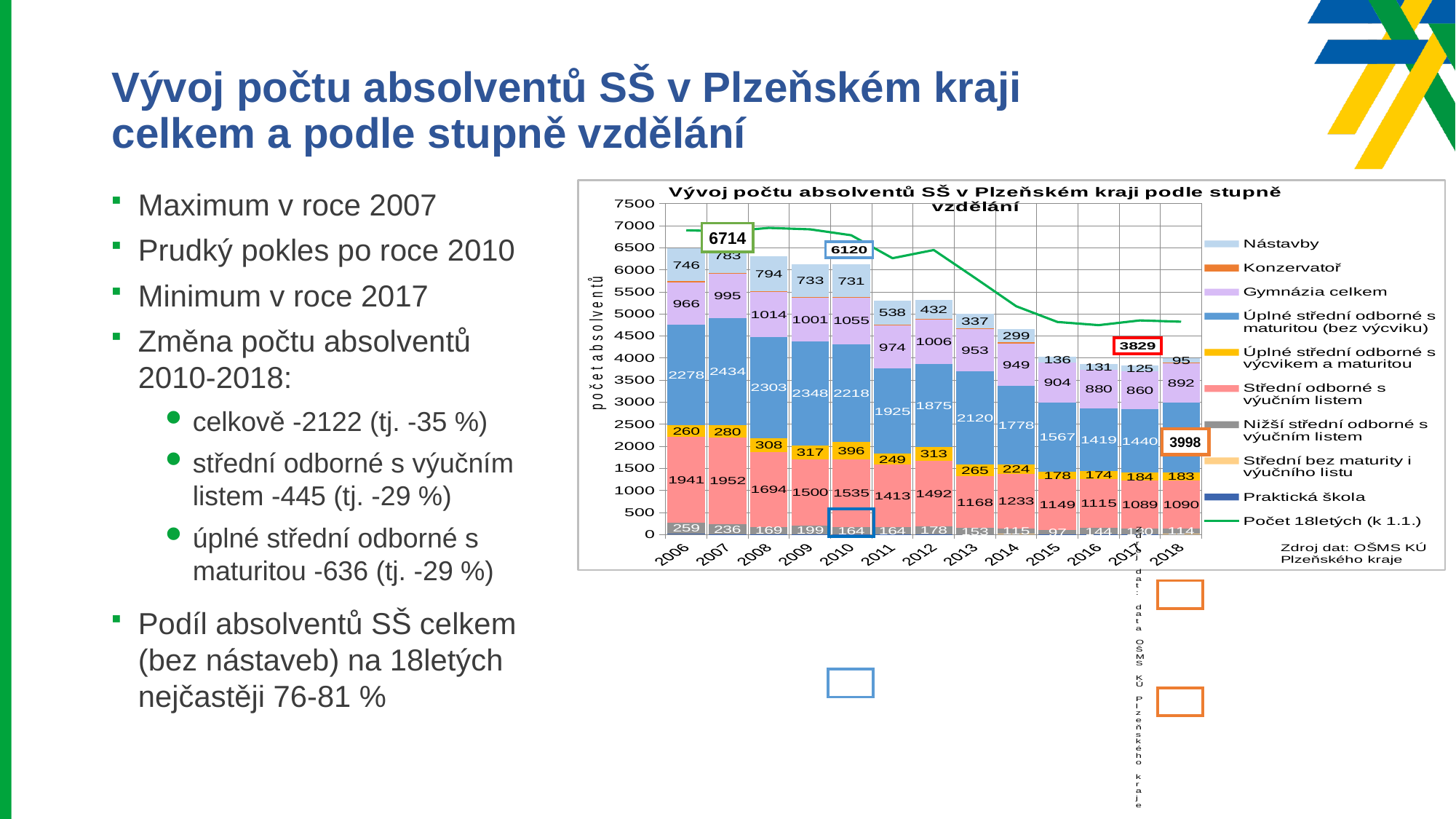
Does the value for Nástavby rise or fall overall from 2006 to 2018? fall What is the value for Nástavby in 2006? 746 What is the difference between the Gymnázia celkem values for 2008 and 2006? 48 In which year is the value for Nástavby lowest? 2018 What kind of chart is shown on the slide? combination bar and line chart (stacked bars with a line) What is the value for Úplné střední odborné s výcvikem a maturitou in 2010? 396 What is the value for Gymnázia celkem in 2010? 1055 How many years are shown on the x axis of the chart? 13 Which year has the larger value for Úplné střední odborné s maturitou (bez výcviku), 2007 or 2009? 2007 Is the value of the Počet 18letých (k 1.1.) line in 2006 greater or less than 6500? greater How many series does the chart legend list? 10 In which year is the value for Střední odborné s výučním listem highest? 2007